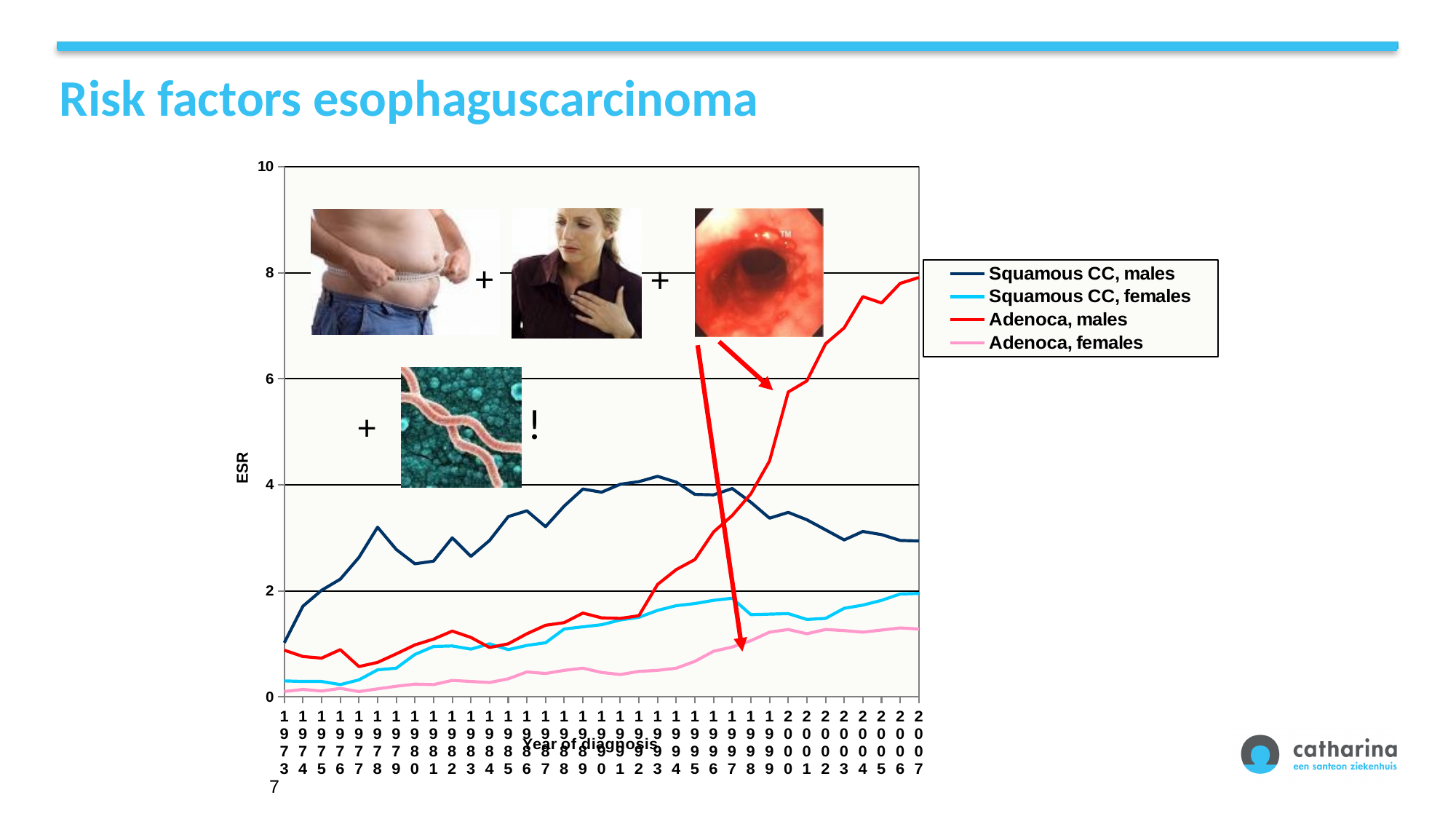
What is the label of the y axis? ESR What kind of chart is shown on the slide? Line chart How many years are plotted along the x axis? 35 Which series has the lowest value in 2007? Adenoca, females Does the Adenoca, males series generally rise or fall from 1973 to 2007? Rise Is the value for Squamous CC, males in 2007 greater or less than 4? less What is the first year shown on the x axis? 1973 In 1990, which is larger: Squamous CC, males or Adenoca, males? Squamous CC, males How many series does the legend list? 4 Is the value for Adenoca, females in 2007 greater or less than 2? less Which series has the highest value in 2007? Adenoca, males Is the value for Adenoca, males in 2007 greater or less than 6? greater